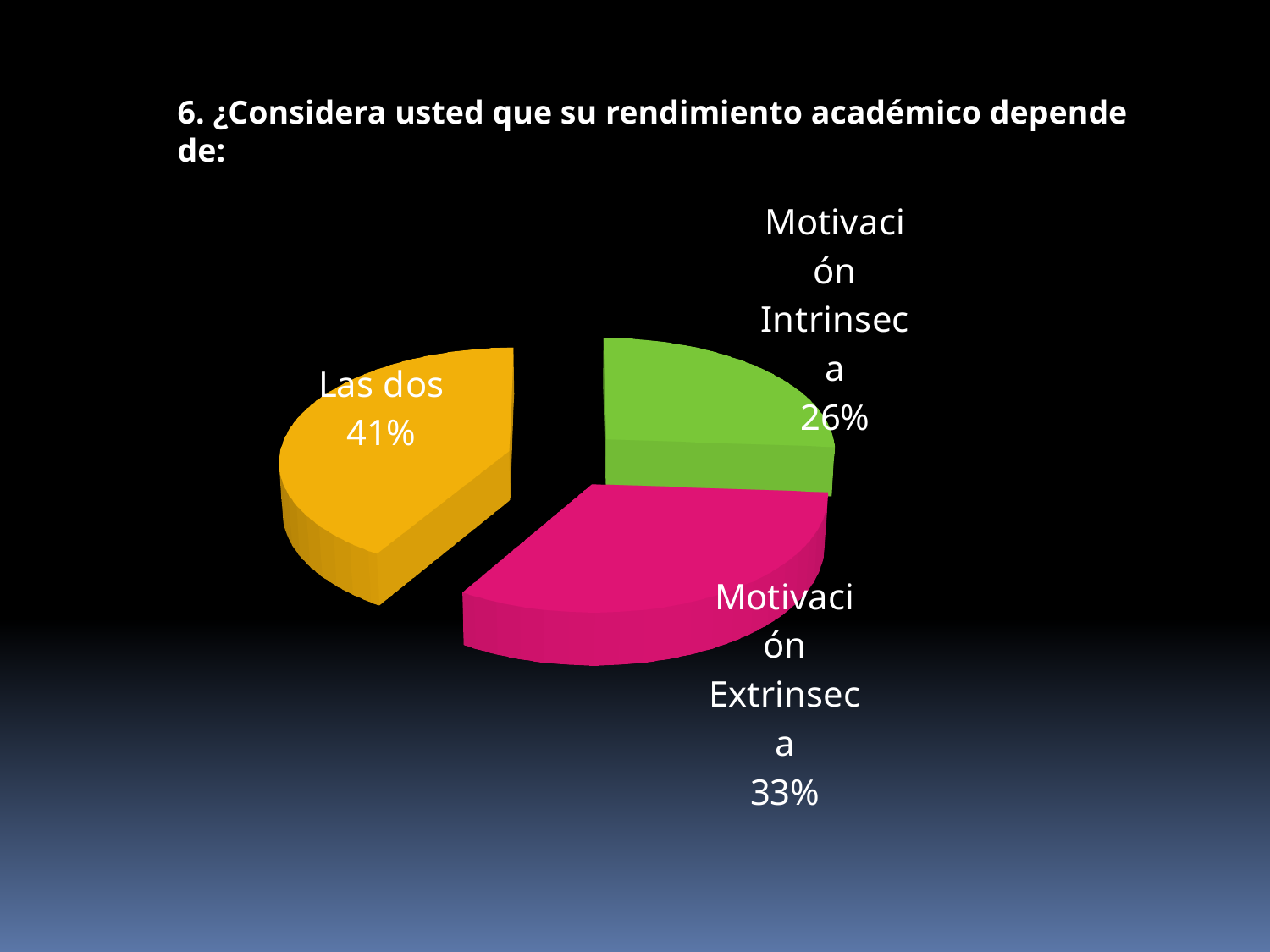
What colour is the "Las dos" slice? Yellow/orange What is the difference in percentage points between "Motivación Extrinseca" and "Motivación Intrinseca"? 7 What kind of chart is shown on the slide? Pie chart Which category has the smallest share of the pie? Motivación Intrinseca What share of the pie does "Motivación Extrinseca" represent? 33% What is the difference in percentage points between "Las dos" and "Motivación Intrinseca"? 15 Which category has the largest share of the pie? Las dos What share of the pie does "Motivación Intrinseca" represent? 26% What is the title of the chart on the slide? 6. ¿Considera usted que su rendimiento académico depende de: What share of the pie does "Las dos" represent? 41% How many slices does the pie chart have? 3 Which is larger, the share for "Motivación Extrinseca" or the share for "Motivación Intrinseca"? Motivación Extrinseca